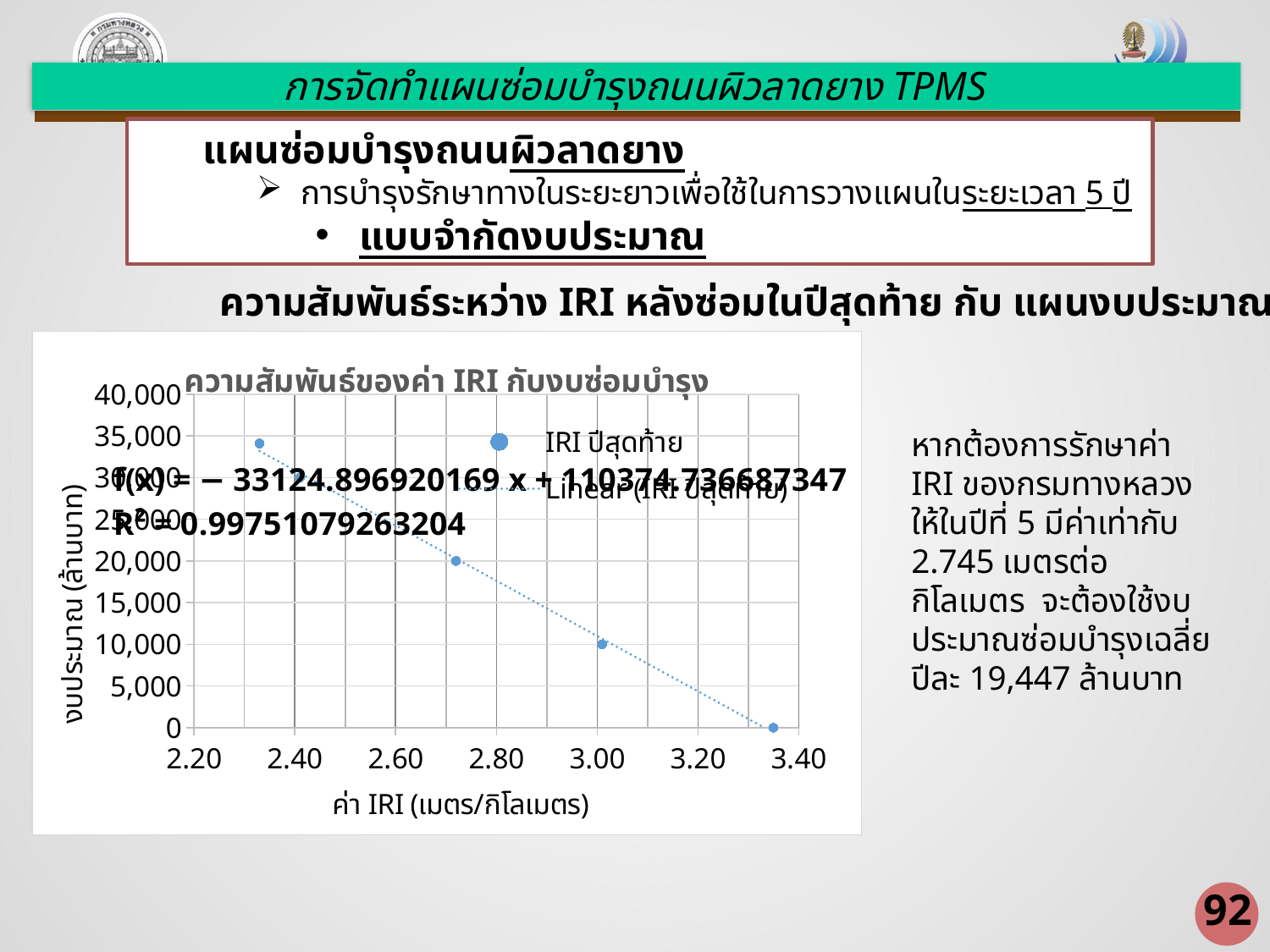
Which data point has the highest budget: the one with the lowest IRI value or the one with the highest IRI value? the one with the lowest IRI value How many data points are plotted in the chart? 5 How many series does the chart legend list? 2 Is the budget for the data point with the lowest IRI value greater or less than 30,000? greater Which has the larger budget: the data point near IRI 2.33 or the data point near IRI 3.01? the data point near IRI 2.33 What is the title of the chart? ความสัมพันธ์ของค่า IRI กับงบซ่อมบำรุง As the IRI value increases along the x axis, does the budget rise or fall? fall Is the budget for the data point with the highest IRI value greater or less than 5,000? less What R² value is printed on the chart? 0.99751079263204 What kind of chart is shown on the slide? scatter chart What is the label of the x axis? ค่า IRI (เมตร/กิโลเมตร)